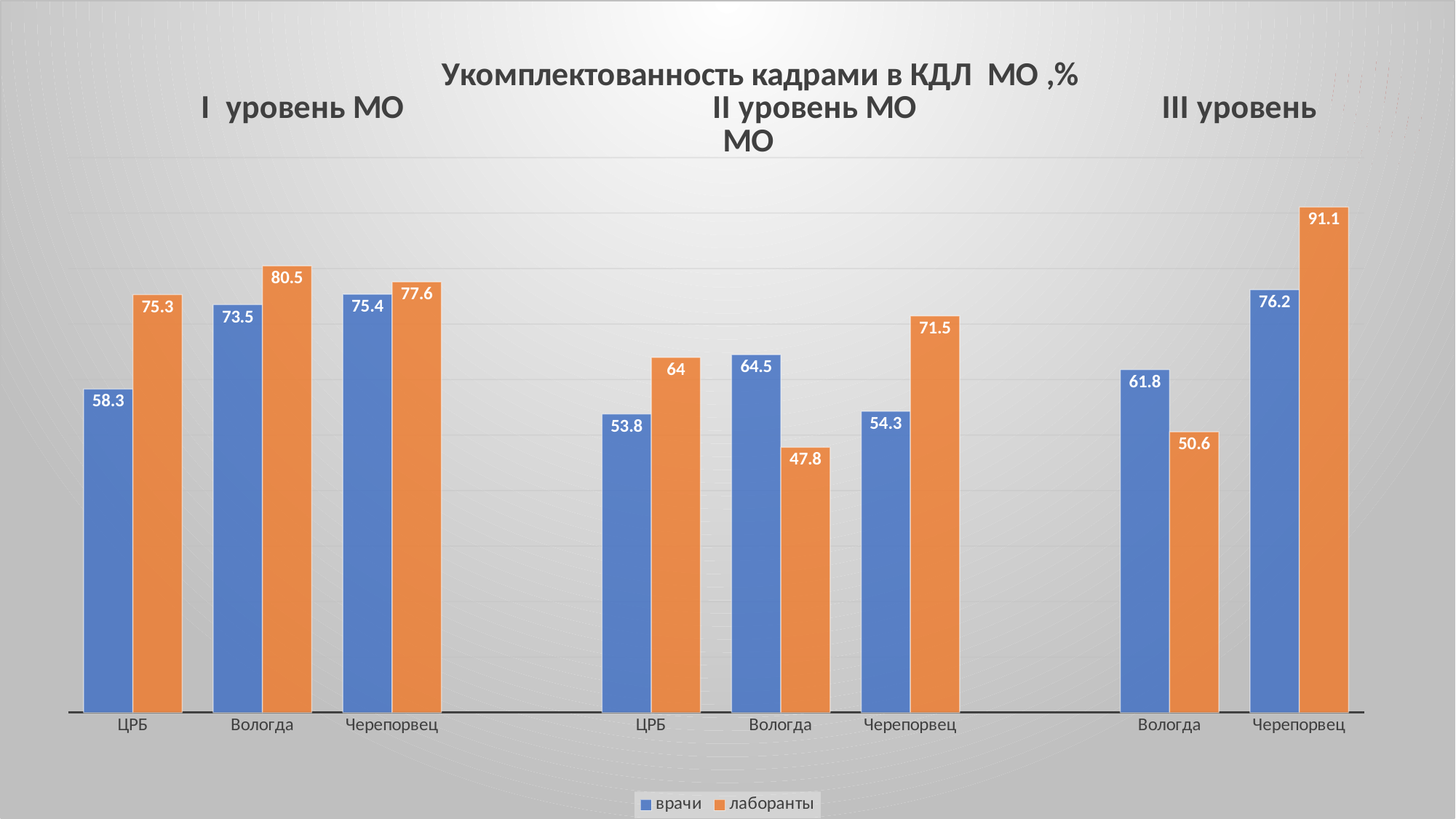
What colour represents лаборанты in the chart? orange How many series does the legend list? 2 In the II уровень МО group at Вологда, which is larger: врачи or лаборанты? врачи What is the value for лаборанты at Вологда in the II уровень МО group? 47.8 Which bar has the lowest value on the chart? лаборанты, Вологда (II уровень МО), 47.8 What kind of chart is shown on the slide? bar chart What is the difference between лаборанты and врачи at ЦРБ in the I уровень МО group? 17 What is the value for врачи at Вологда in the III уровень МО group? 61.8 What is the value for лаборанты at Черепорвец in the III уровень МО group? 91.1 Which bar has the highest value on the chart? лаборанты, Черепорвец (III уровень МО), 91.1 How many category groups (levels of МО) are shown on the chart? 3 What is the value for врачи at ЦРБ in the I уровень МО group? 58.3